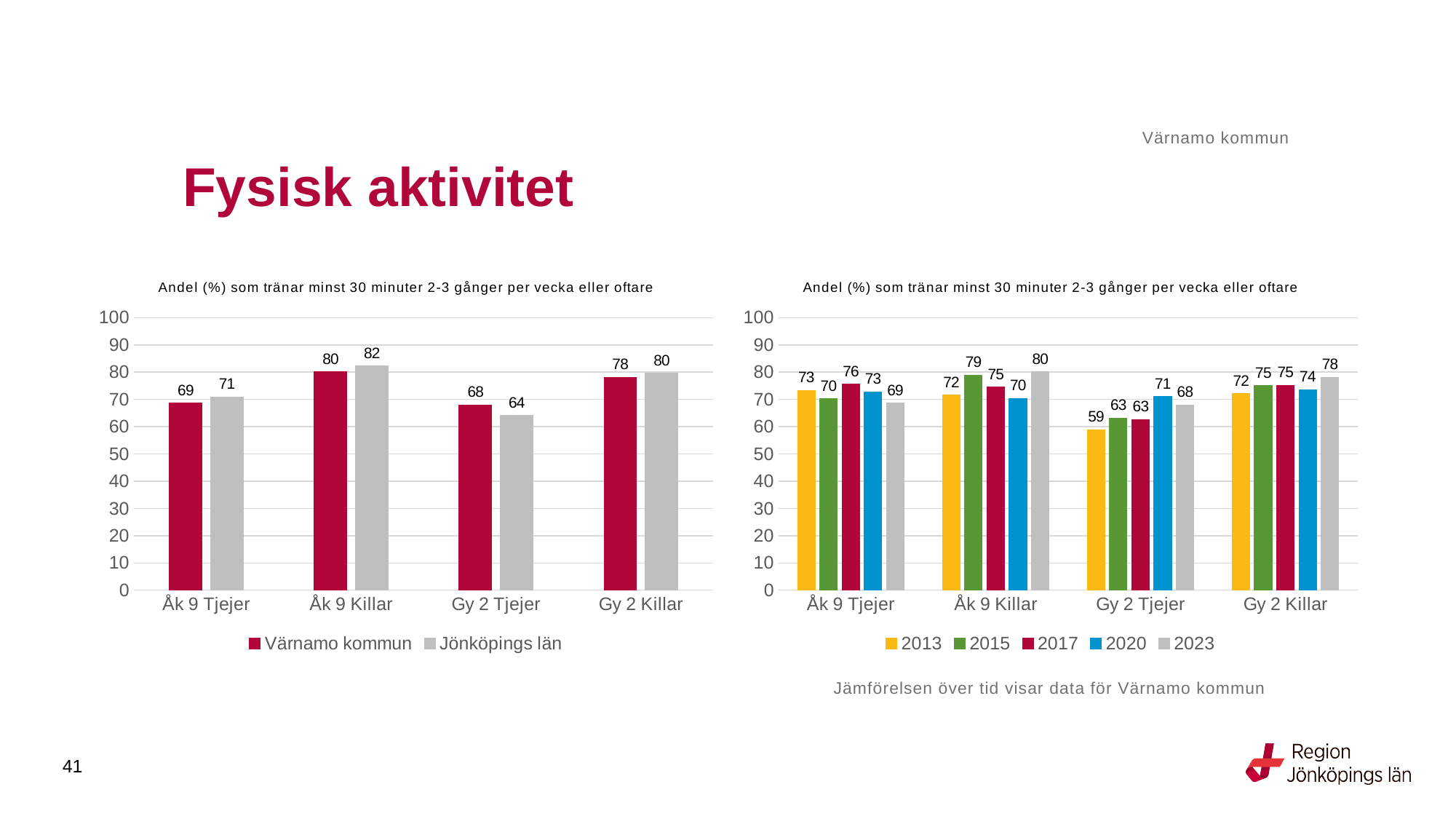
In the right chart, what is the value for 2020 for Gy 2 Tjejer? 71 How many series does the legend of the left chart list? 2 In the right chart, which year has the lowest value for Gy 2 Tjejer? 2013 In the left chart, which is larger for Åk 9 Killar: Värnamo kommun or Jönköpings län? Jönköpings län In the right chart, what is the difference between the 2013 and 2023 values for Gy 2 Tjejer? 9 In the right chart, what is the value for 2023 for Åk 9 Killar? 80 What type of chart is the right chart? Bar chart In the left chart, what is the value for Jönköpings län for Gy 2 Tjejer? 64 How many series does the legend of the right chart list? 5 In the left chart, what is the value for Värnamo kommun for Åk 9 Tjejer? 69 In the left chart, what is the difference between Värnamo kommun and Jönköpings län for Gy 2 Tjejer? 4 In the left chart, which category has the highest value for Jönköpings län? Åk 9 Killar